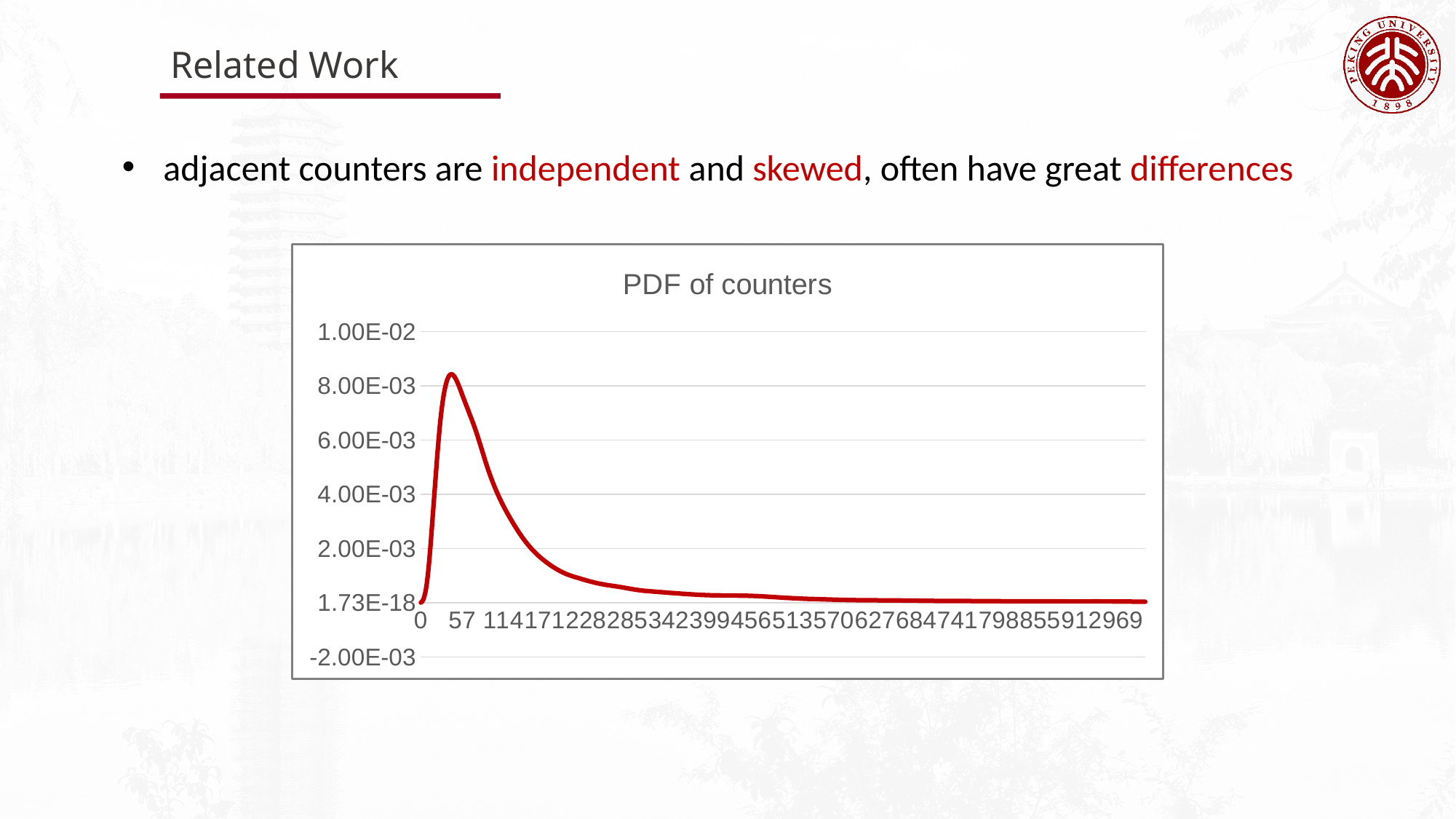
Is the value of the line at x = 513 greater or less than 2.00E-03? less How many tick labels are shown on the x axis? 18 What colour is the plotted line in the chart? red Is the peak value of the line greater or less than 1.00E-02? less What kind of chart is shown on the slide? line chart Is the peak value of the line greater or less than 6.00E-03? greater What is the highest tick label on the y axis? 1.00E-02 After reaching its peak, does the line rise or fall as x increases? fall What is the first label on the x axis? 0 What is the title of the chart? PDF of counters What is the last label on the x axis? 969